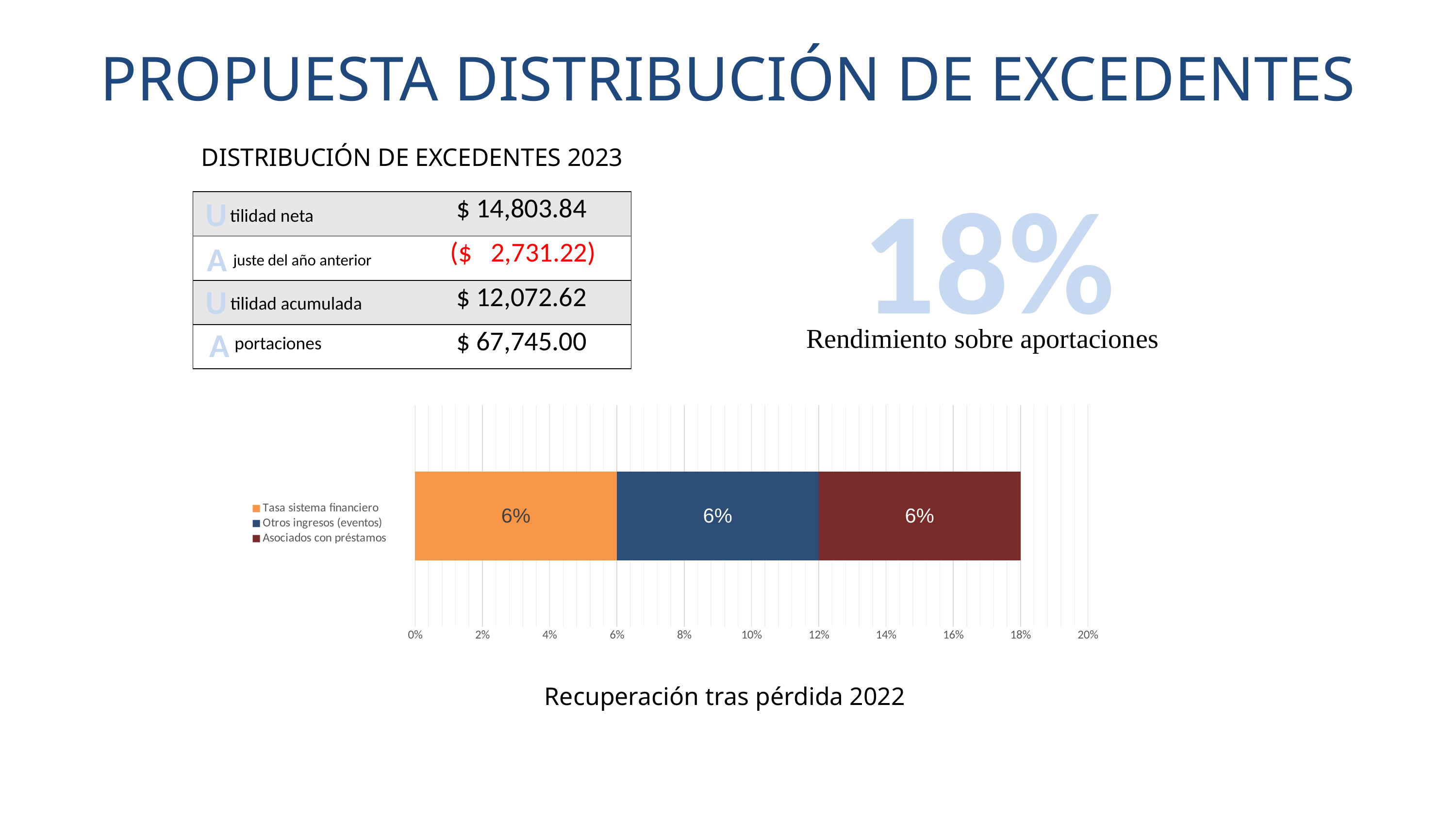
How many series does the chart legend list? 3 Is the total of the stacked bar greater or less than 20%? less What is the difference between the Tasa sistema financiero and Asociados con préstamos segments? 0% What is the total of the stacked bar in the chart? 18% Which legend entry is shown in orange? Tasa sistema financiero Is the total of the stacked bar greater or less than 16%? greater What is the value of the Asociados con préstamos segment in the bar chart? 6% What is the value of the Otros ingresos (eventos) segment in the bar chart? 6% How many bars are plotted in the chart? 1 Which legend entry is shown in dark red? Asociados con préstamos What is the value of the Tasa sistema financiero segment in the bar chart? 6% What type of chart is shown on the slide? stacked bar chart